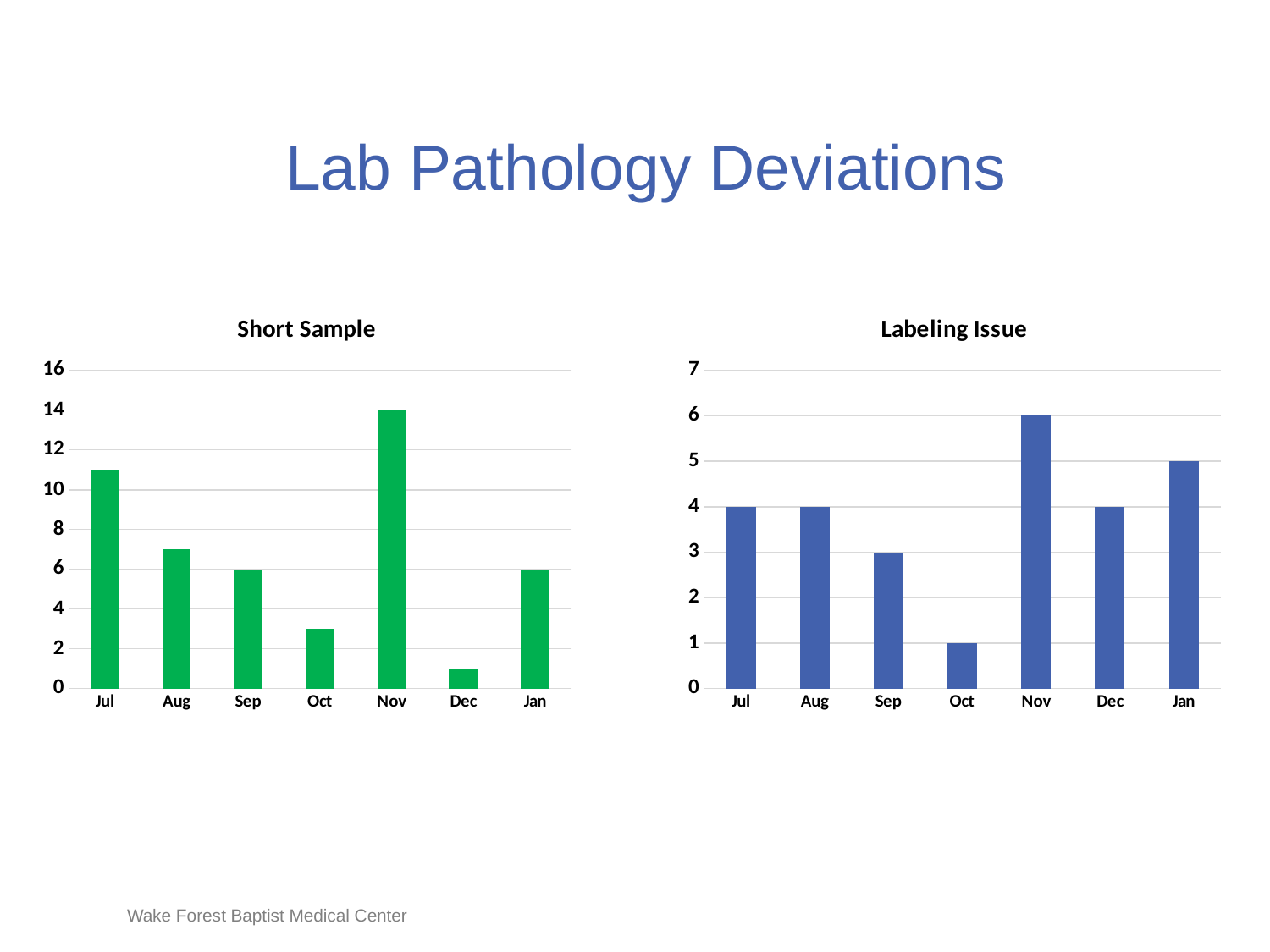
In the Short Sample chart, which month has the lowest value? Dec In the Labeling Issue chart, which month has the lowest value? Oct In the Short Sample chart, which month has the highest value? Nov In the Short Sample chart, how many months are shown on the x axis? 7 In the Short Sample chart, is the value for Oct greater or less than 4? less In the Short Sample chart, is the value for Jul greater or less than 10? greater In the Labeling Issue chart, which month has the highest value? Nov In the Labeling Issue chart, what is the value for Jan? 5 In the Labeling Issue chart, what is the difference between the values for Nov and Oct? 5 In the Labeling Issue chart, which is larger, the value for Sep or the value for Dec? Dec What kind of chart is the Labeling Issue chart? Bar chart In the Short Sample chart, what is the value for Nov? 14